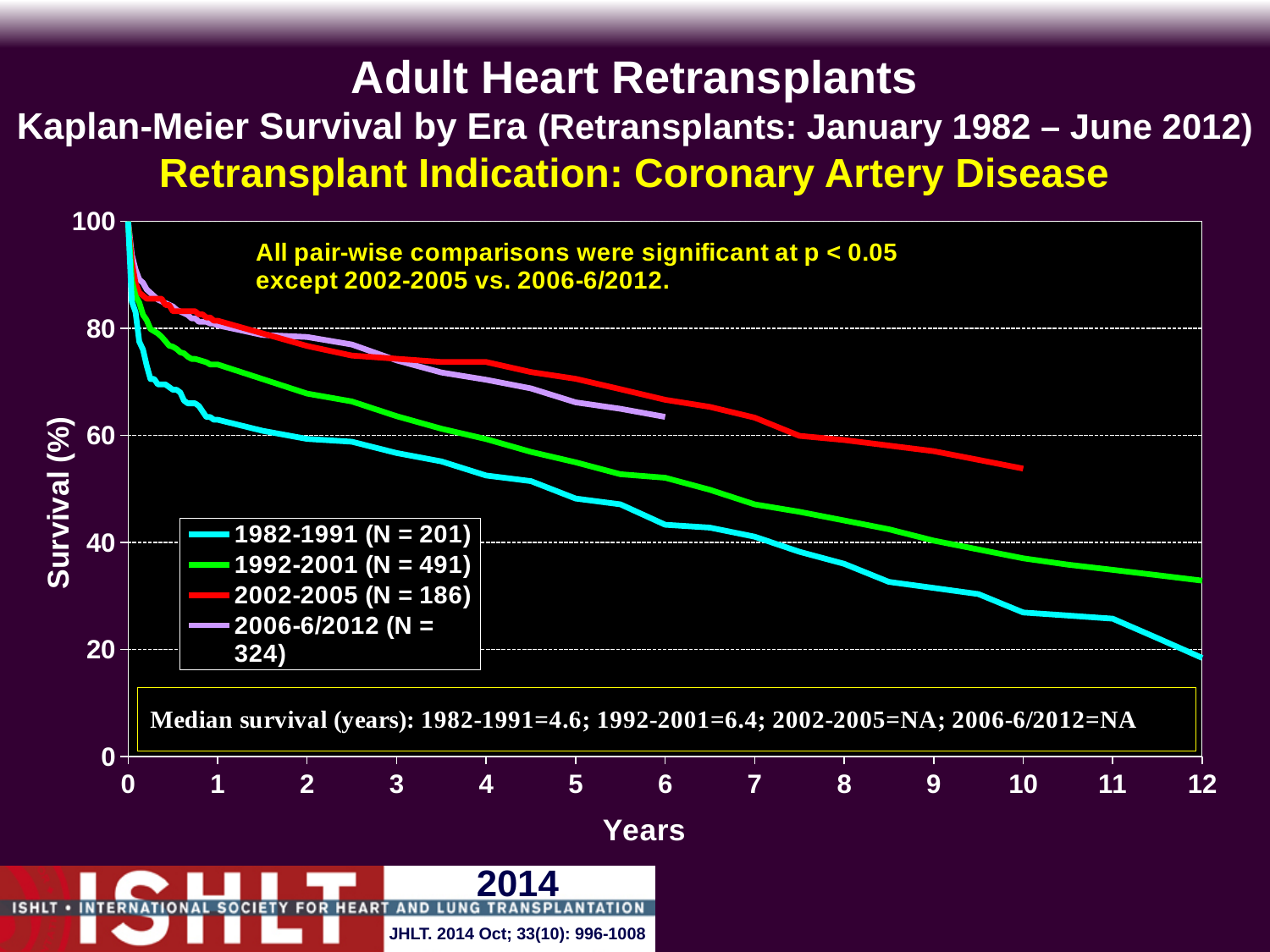
Which era has the lowest survival at 6 years? 1982-1991 What is the median survival in years for the 1992-2001 era? 6.4 How many series does the legend list? 4 Is the survival for the 1992-2001 era at 12 years greater or less than 40? less Is the survival for the 2002-2005 era at 10 years greater or less than 60? less What is the median survival in years for the 1982-1991 era? 4.6 What is the difference in median survival (years) between the 1992-2001 era and the 1982-1991 era? 1.8 Which era in the legend has N = 324? 2006-6/2012 Is the survival for the 1982-1991 era at 10 years greater or less than 40? less At 5 years, which era has higher survival, 1992-2001 or 1982-1991? 1992-2001 According to the legend, what is N for the 1982-1991 era? 201 What kind of chart is shown on the slide? line chart